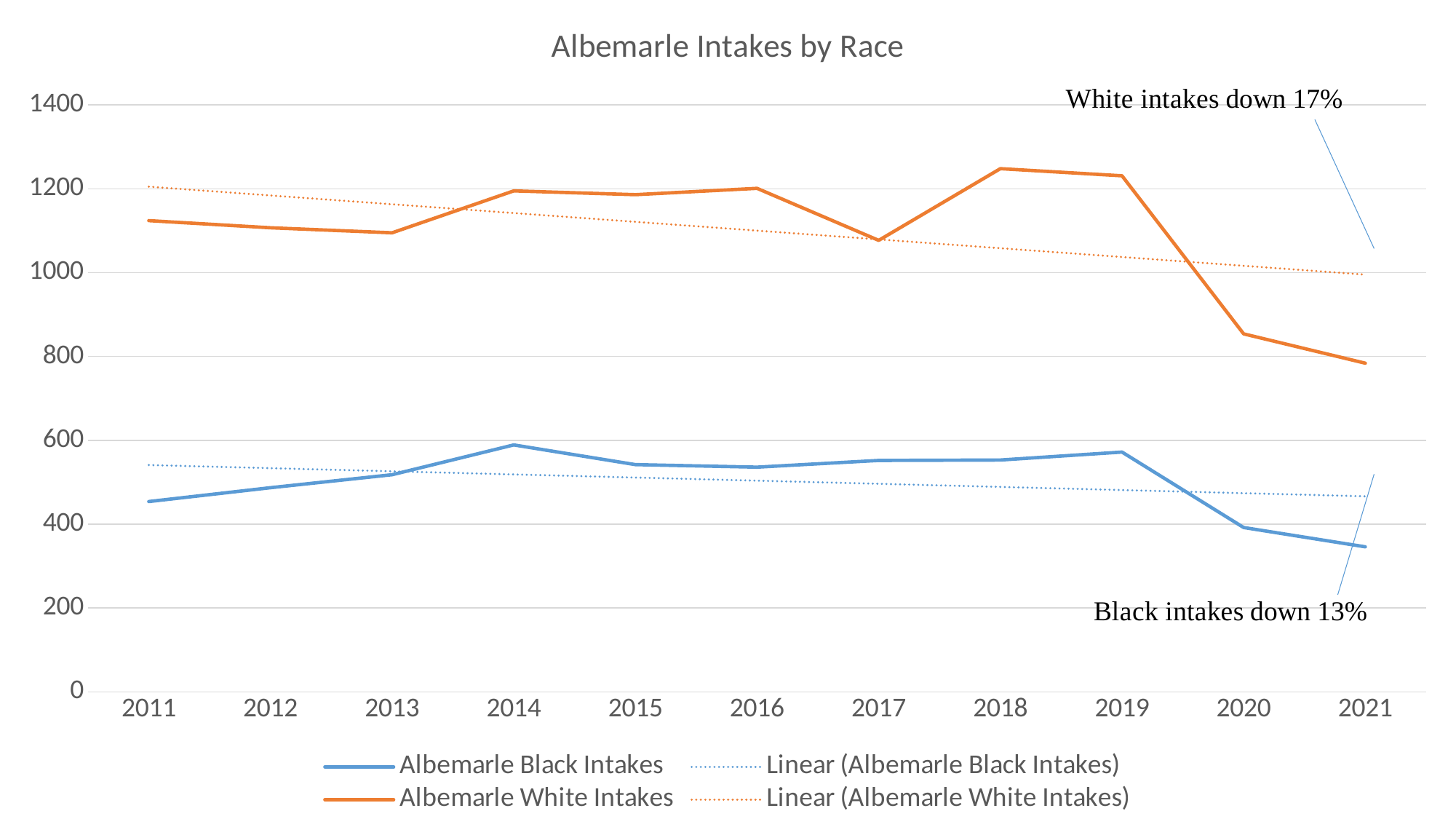
What type of chart is shown on the slide? line chart In which year is the Albemarle White Intakes value lowest? 2021 What is the title of the chart? Albemarle Intakes by Race Is the Albemarle Black Intakes value for 2021 greater or less than 400? less Do the Albemarle White Intakes rise or fall from 2019 to 2021? fall In which year is the Albemarle Black Intakes value lowest? 2021 Is the Albemarle White Intakes value for 2020 greater or less than 1000? less Which is larger, the Albemarle White Intakes value for 2014 or for 2017? 2014 How many entries does the legend list? 4 According to the annotation on the chart, by what percentage are White intakes down? 17% How many years are shown on the x axis? 11 Is the Albemarle White Intakes value for 2018 greater or less than 1200? greater